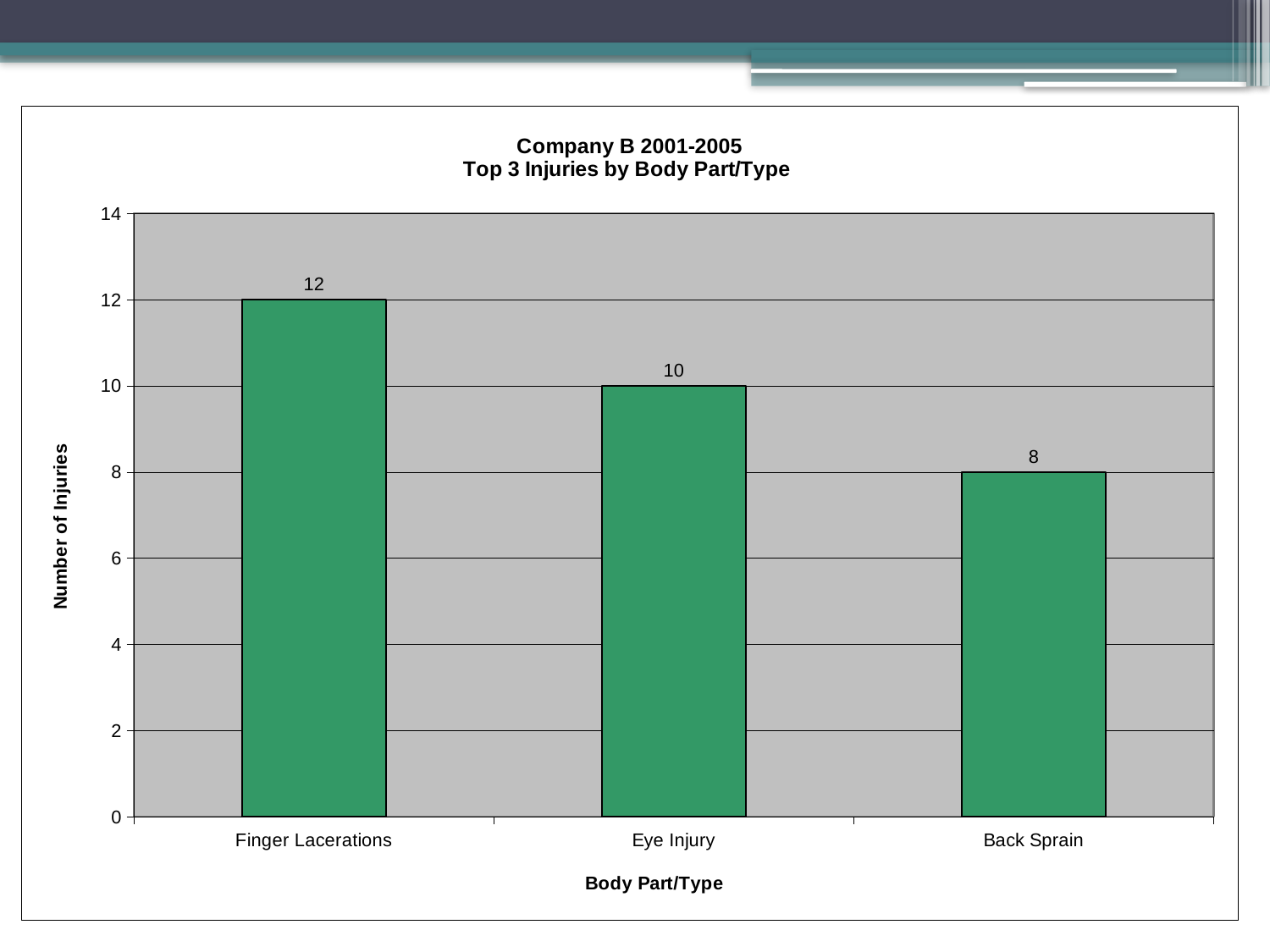
Which body part/type has the highest number of injuries? Finger Lacerations What is the number of injuries for Eye Injury? 10 What is the difference in number of injuries between Finger Lacerations and Back Sprain? 4 What is the number of injuries for Back Sprain? 8 What is the difference in number of injuries between Eye Injury and Back Sprain? 2 What is the title of the chart? Company B 2001-2005 Top 3 Injuries by Body Part/Type What kind of chart is shown on the slide? Bar chart Which body part/type has the lowest number of injuries? Back Sprain What is the number of injuries for Finger Lacerations? 12 Which has more injuries, Eye Injury or Back Sprain? Eye Injury How many body part/type categories are shown in the chart? 3 Do the values rise or fall from left to right across the categories? Fall